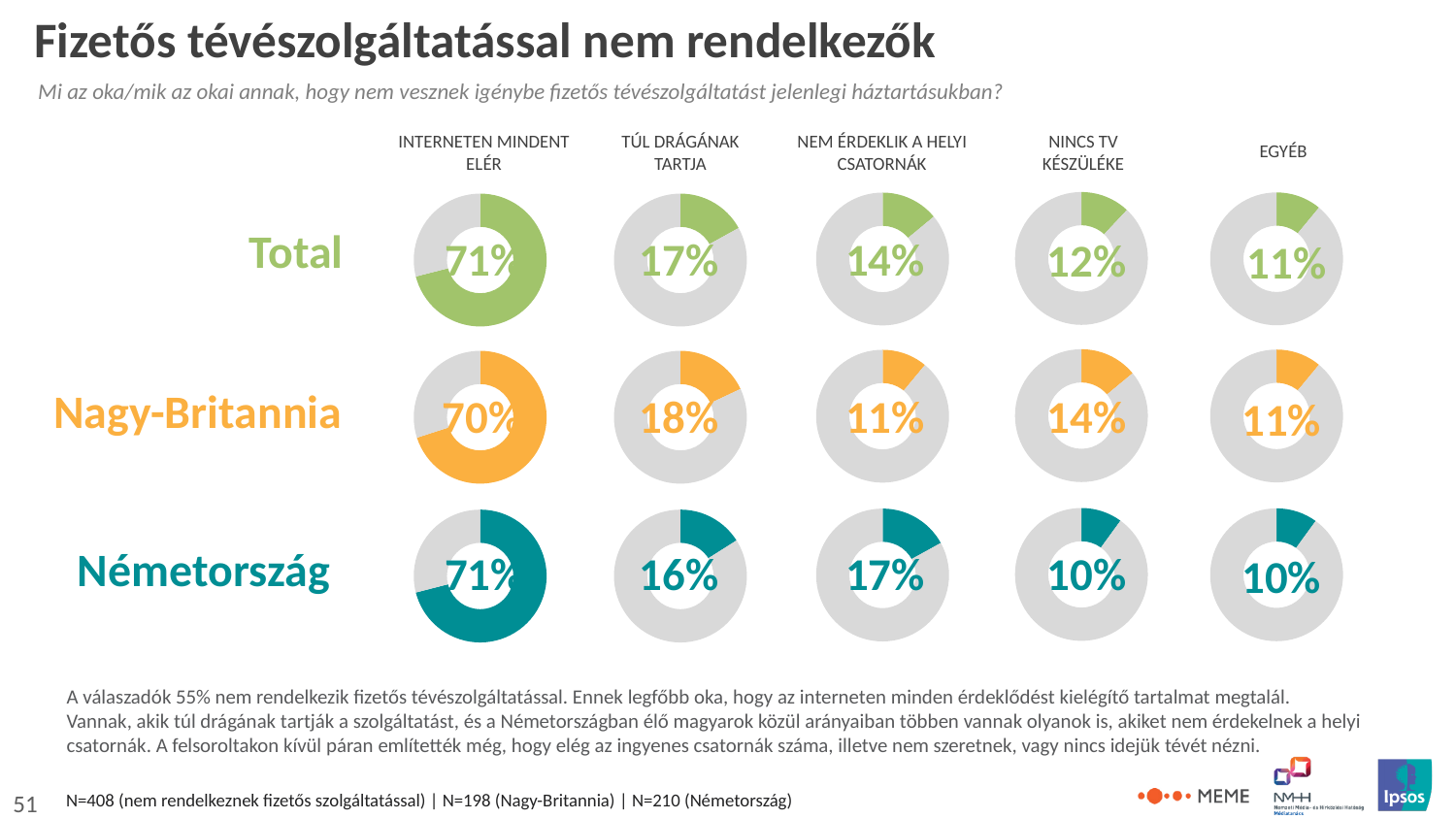
In the donut chart for Total under "Interneten mindent elér", what percentage is shown? 71% In the "Nincs TV készüléke" column, which is larger: the Nagy-Britannia value or the Németország value? Nagy-Britannia Across the Németország row of donut charts, which reason has the lowest percentage? Nincs TV készüléke and Egyéb (both 10%) What is the difference between the Nagy-Britannia and Németország values in the "Interneten mindent elér" donut charts? 1 percentage point In the donut chart for Németország under "Nem érdeklik a helyi csatornák", what percentage is shown? 17% Across the Total row of donut charts, which reason has the highest percentage? Interneten mindent elér What type of chart is used to display the percentages on the slide? Donut (pie) chart In the donut chart for Németország under "Egyéb", what percentage is shown? 10% How many donut charts are shown on the slide in total? 15 What colour are the donut chart segments in the Németország row? Teal In the donut chart for Nagy-Britannia under "Nincs TV készüléke", what percentage is shown? 14% In the donut chart for Nagy-Britannia under "Túl drágának tartja", what percentage is shown? 18%